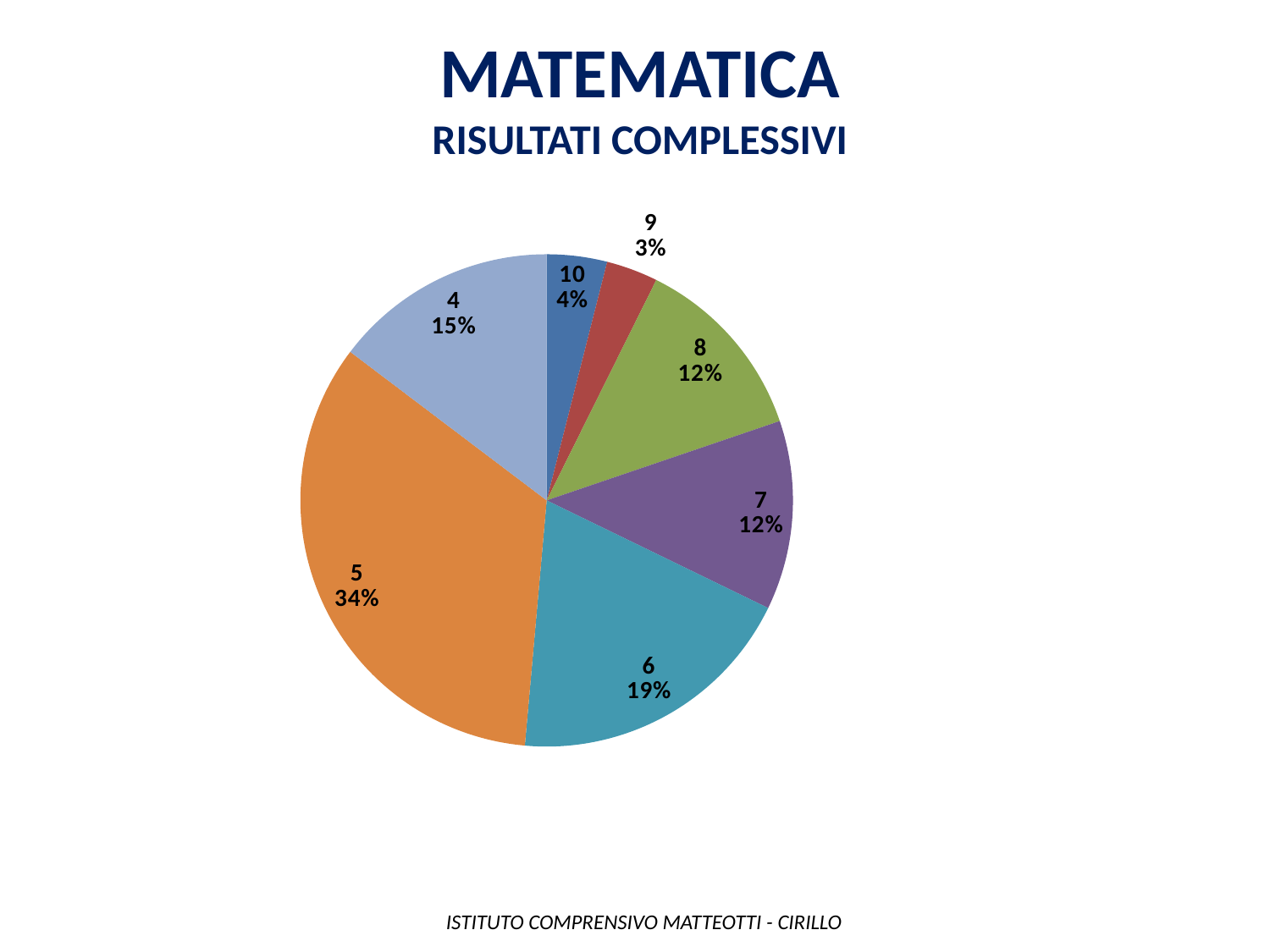
What percentage is shown for grade 4? 15% What percentage is shown for grade 6? 19% Which has a larger share, grade 6 or grade 8? 6 What is the subtitle of the chart below MATEMATICA? RISULTATI COMPLESSIVI What type of chart is shown on the slide? pie chart What percentage is shown for grade 10? 4% How many slices does the pie chart have? 7 Which grade has the largest slice of the pie? 5 What is the difference in percentage points between grade 5 and grade 6? 15 Which grade has the smallest slice of the pie? 9 What is the difference in percentage points between grade 4 and grade 10? 11 What share of the pie does grade 5 represent? 34%